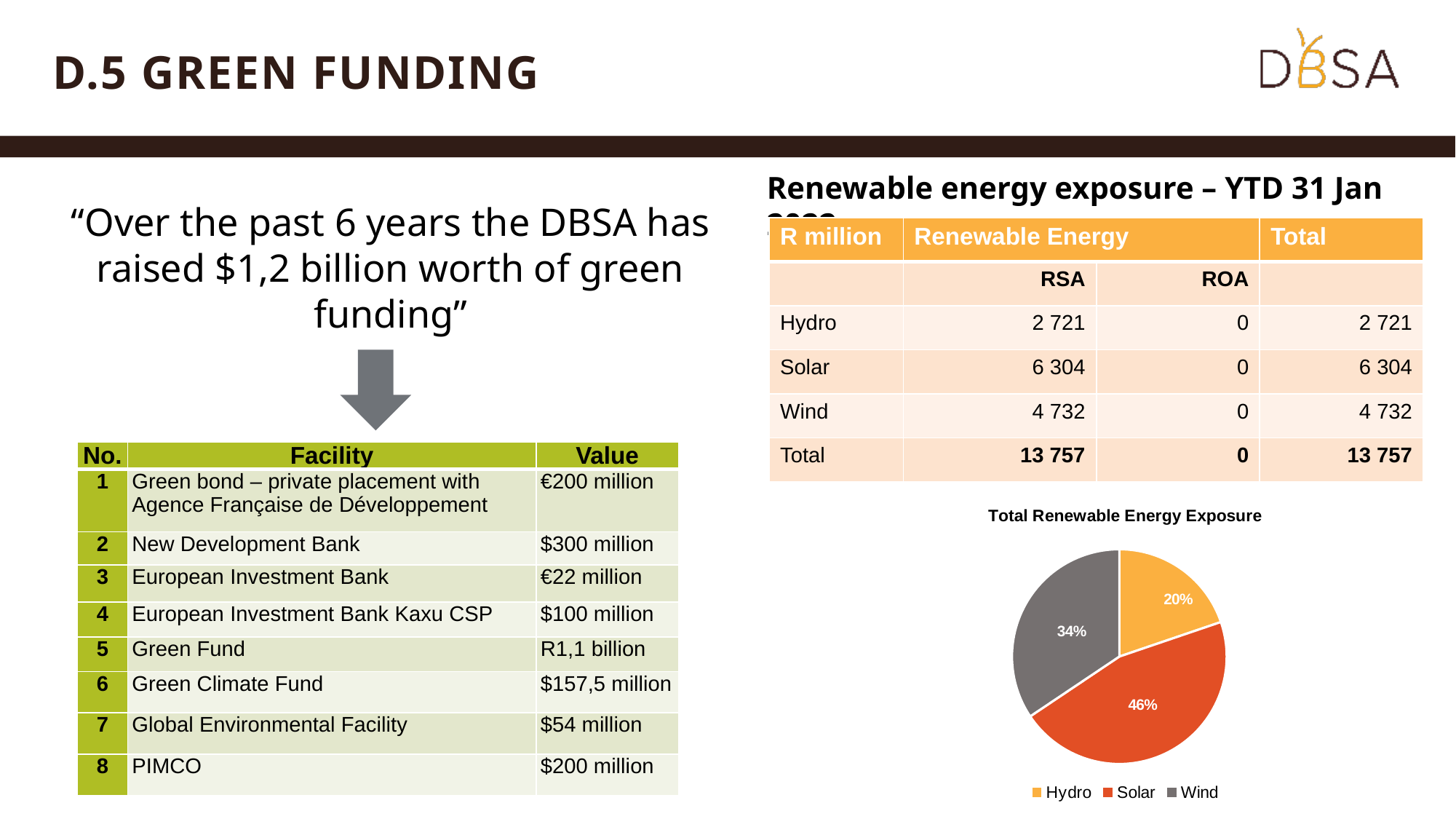
What is the title of the pie chart? Total Renewable Energy Exposure In the pie chart, what share does Wind have? 34% In the pie chart, what colour is the Solar slice? orange-red In the pie chart, what share does Solar have? 46% Which slice of the pie chart is the largest? Solar How many slices does the pie chart have? 3 In the pie chart, which is larger, Wind or Hydro? Wind What kind of chart is the "Total Renewable Energy Exposure" chart? pie chart In the pie chart, what share does Hydro have? 20% How many entries does the pie chart's legend list? 3 Which slice of the pie chart is the smallest? Hydro In the pie chart, what is the difference in percentage points between Solar and Wind? 12